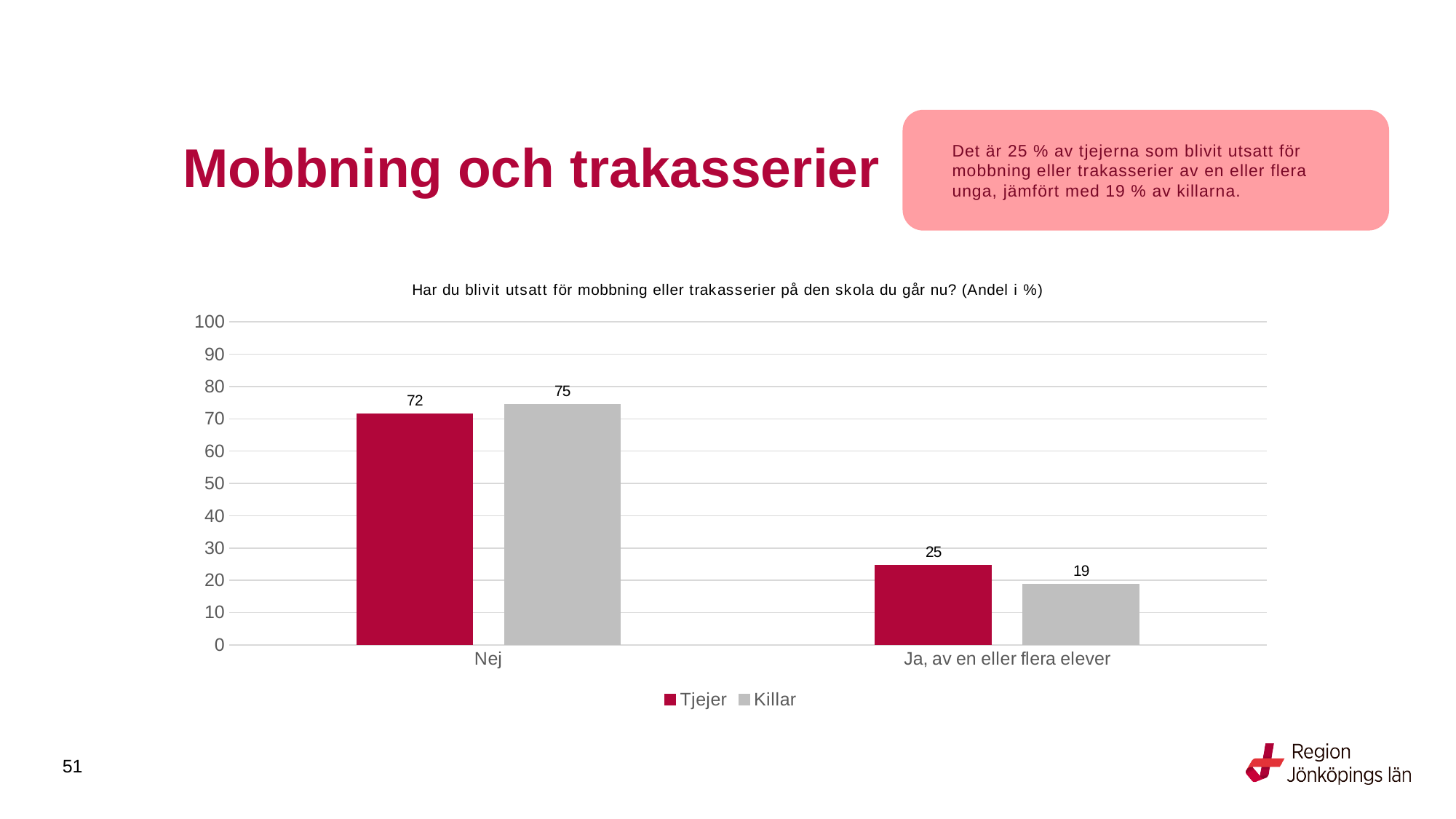
Which series has the highest value in the Nej category? Killar How many categories are shown on the x axis? 2 What is the value for Killar in the Nej category? 75 Which series has the lowest value in the 'Ja, av en eller flera elever' category? Killar What is the difference between Killar and Tjejer in the Nej category? 3 How many series does the legend list? 2 What is the difference between Tjejer and Killar in the 'Ja, av en eller flera elever' category? 6 Which is larger: Tjejer for Nej or Tjejer for 'Ja, av en eller flera elever'? Tjejer for Nej What is the value for Tjejer in the Nej category? 72 What is the value for Tjejer in the 'Ja, av en eller flera elever' category? 25 What kind of chart is shown on the slide? Bar chart What is the value for Killar in the 'Ja, av en eller flera elever' category? 19